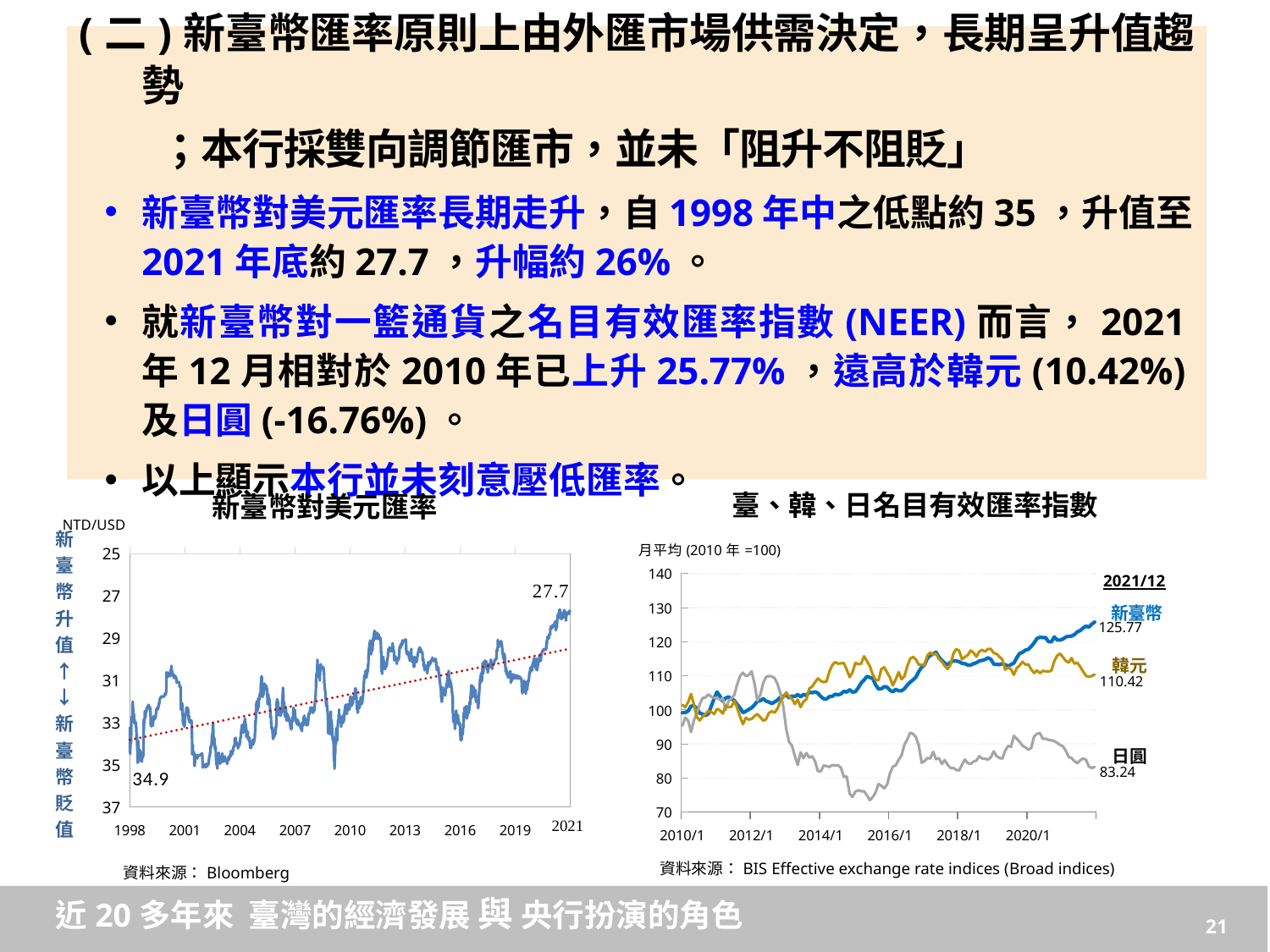
In the chart titled 新臺幣對美元匯率, what is the labelled value at the end of the series in 2021? 27.7 In the chart titled 新臺幣對美元匯率, what unit is shown above the y axis? NTD/USD In the chart titled 臺、韓、日名目有效匯率指數, what is the value for 新臺幣 at 2021/12? 125.77 In the chart titled 臺、韓、日名目有效匯率指數, which series has the lowest value at 2021/12? 日圓 In the chart titled 新臺幣對美元匯率, what is the labelled value near the start of the series in 1998? 34.9 How many series are plotted in the chart titled 臺、韓、日名目有效匯率指數? 3 In the chart titled 臺、韓、日名目有效匯率指數, which series has the highest value at 2021/12? 新臺幣 What kind of chart is the chart titled 新臺幣對美元匯率? Line chart In the chart titled 臺、韓、日名目有效匯率指數, what is the value for 韓元 at 2021/12? 110.42 In the chart titled 臺、韓、日名目有效匯率指數, what is the difference between the 新臺幣 and 韓元 values at 2021/12? 15.35 In the chart titled 新臺幣對美元匯率, what is the difference between the labelled 1998 value and the labelled 2021 value? 7.2 In the chart titled 臺、韓、日名目有效匯率指數, what is the value for 日圓 at 2021/12? 83.24